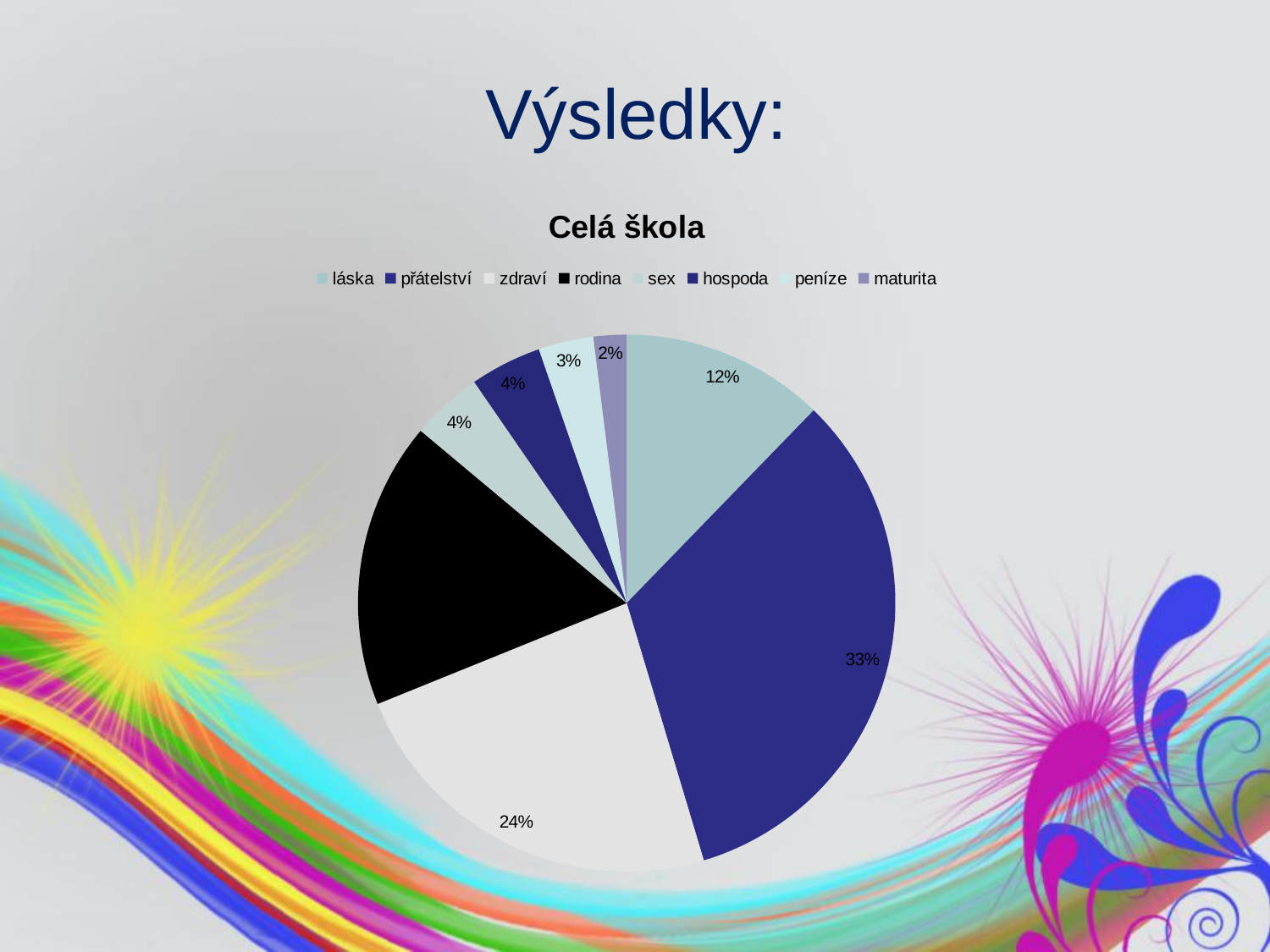
How many categories does the legend of the pie chart list? 8 Which slice is larger, láska or peníze? láska Which category has the smallest slice of the pie? maturita Which category has the largest slice of the pie? přátelství What is the title of the chart? Celá škola What is the difference in percentage points between přátelství and zdraví? 9% What share of the pie does láska have? 12% What share of the pie does zdraví have? 24% What share of the pie does přátelství have? 33% What share of the pie does maturita have? 2% What share of the pie does peníze have? 3% What kind of chart is shown on the slide? pie chart